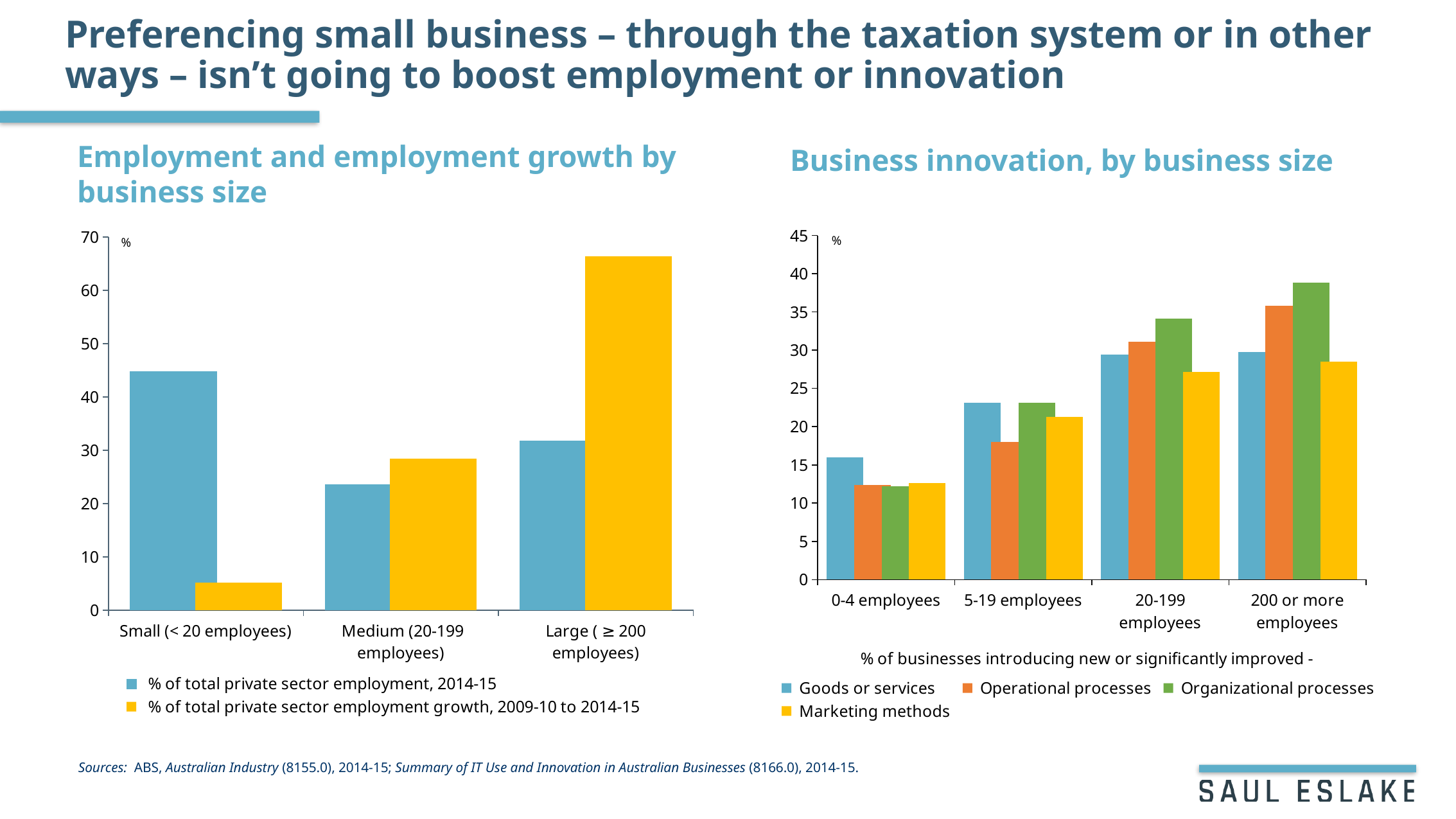
What kind of chart is the 'Employment and employment growth by business size' chart? bar chart In the 'Business innovation, by business size' chart, which business size category has the highest value for Organizational processes? 200 or more employees In the 'Employment and employment growth by business size' chart, which business size has the highest % of total private sector employment growth, 2009-10 to 2014-15? Large ( ≥ 200 employees) In the 'Employment and employment growth by business size' chart, which business size has the lowest % of total private sector employment growth, 2009-10 to 2014-15? Small (< 20 employees) How many business size categories are shown on the 'Employment and employment growth by business size' chart? 3 In the 'Employment and employment growth by business size' chart, is the % of total private sector employment, 2014-15 for Small (< 20 employees) greater or less than 40? greater In the 'Employment and employment growth by business size' chart, is the % of total private sector employment growth, 2009-10 to 2014-15 for Large ( ≥ 200 employees) greater or less than 60? greater How many series does the legend of the 'Business innovation, by business size' chart list? 4 In the 'Business innovation, by business size' chart, which business size category has the lowest value for Goods or services? 0-4 employees How many series does the legend of the 'Employment and employment growth by business size' chart list? 2 In the 'Employment and employment growth by business size' chart, for Small (< 20 employees), which is larger: % of total private sector employment, 2014-15 or % of total private sector employment growth, 2009-10 to 2014-15? % of total private sector employment, 2014-15 In the 'Business innovation, by business size' chart, do the values for Operational processes rise or fall as business size increases along the x axis? rise